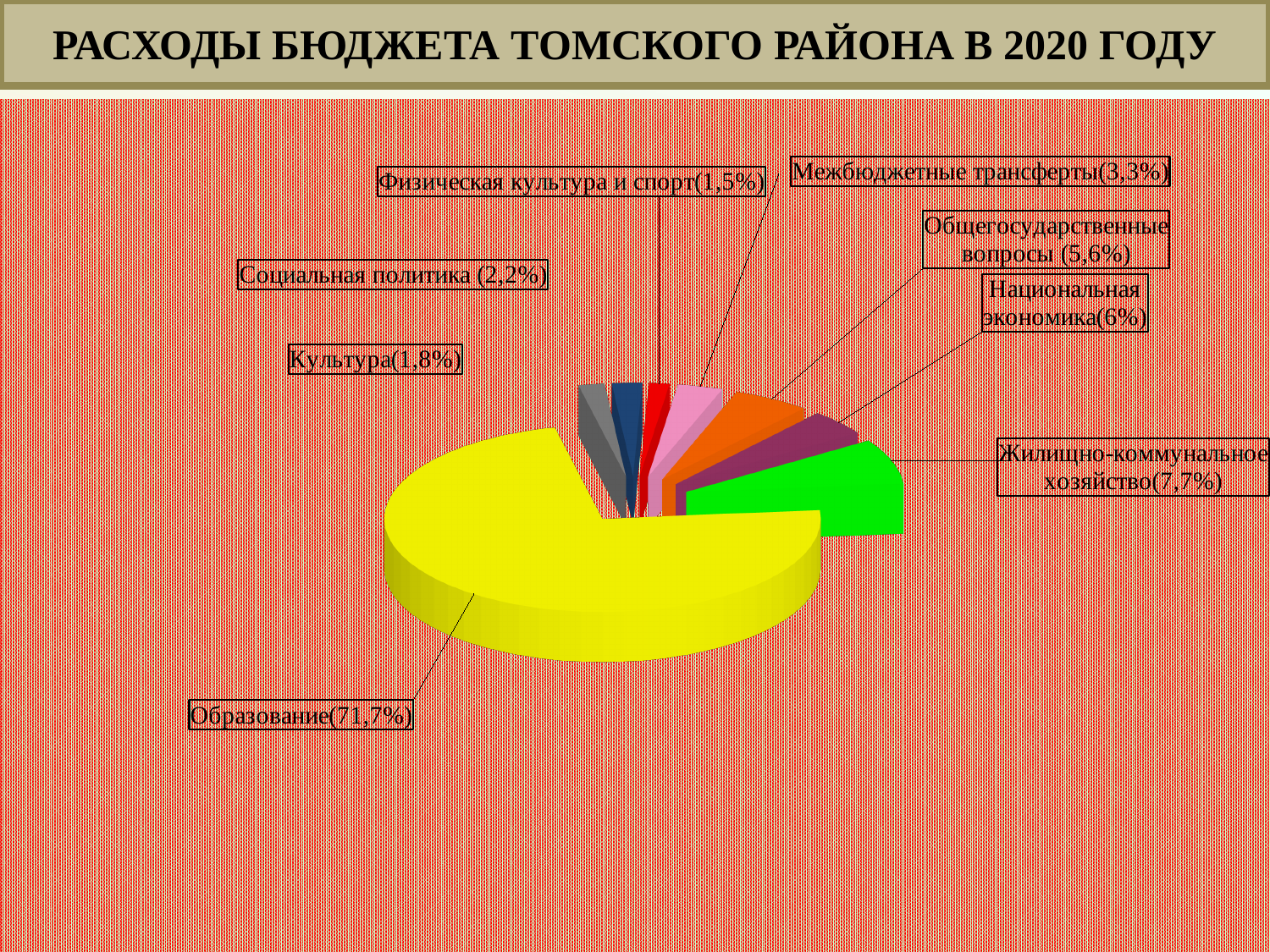
What share is shown for Общегосударственные вопросы? 5,6% What share is shown for Физическая культура и спорт? 1,5% How many categories are labelled on the pie chart? 8 What is the difference between the shares for Жилищно-коммунальное хозяйство and Национальная экономика? 1,7% Which category has the largest share of the budget expenses? Образование What kind of chart is shown on the slide? Pie chart What share is shown for Жилищно-коммунальное хозяйство? 7,7% What share of the budget expenses goes to Образование? 71,7% What share is shown for Национальная экономика? 6% Which is larger: the share for Социальная политика or the share for Культура? Социальная политика What share is shown for Межбюджетные трансферты? 3,3% Which category has the smallest share of the budget expenses? Физическая культура и спорт